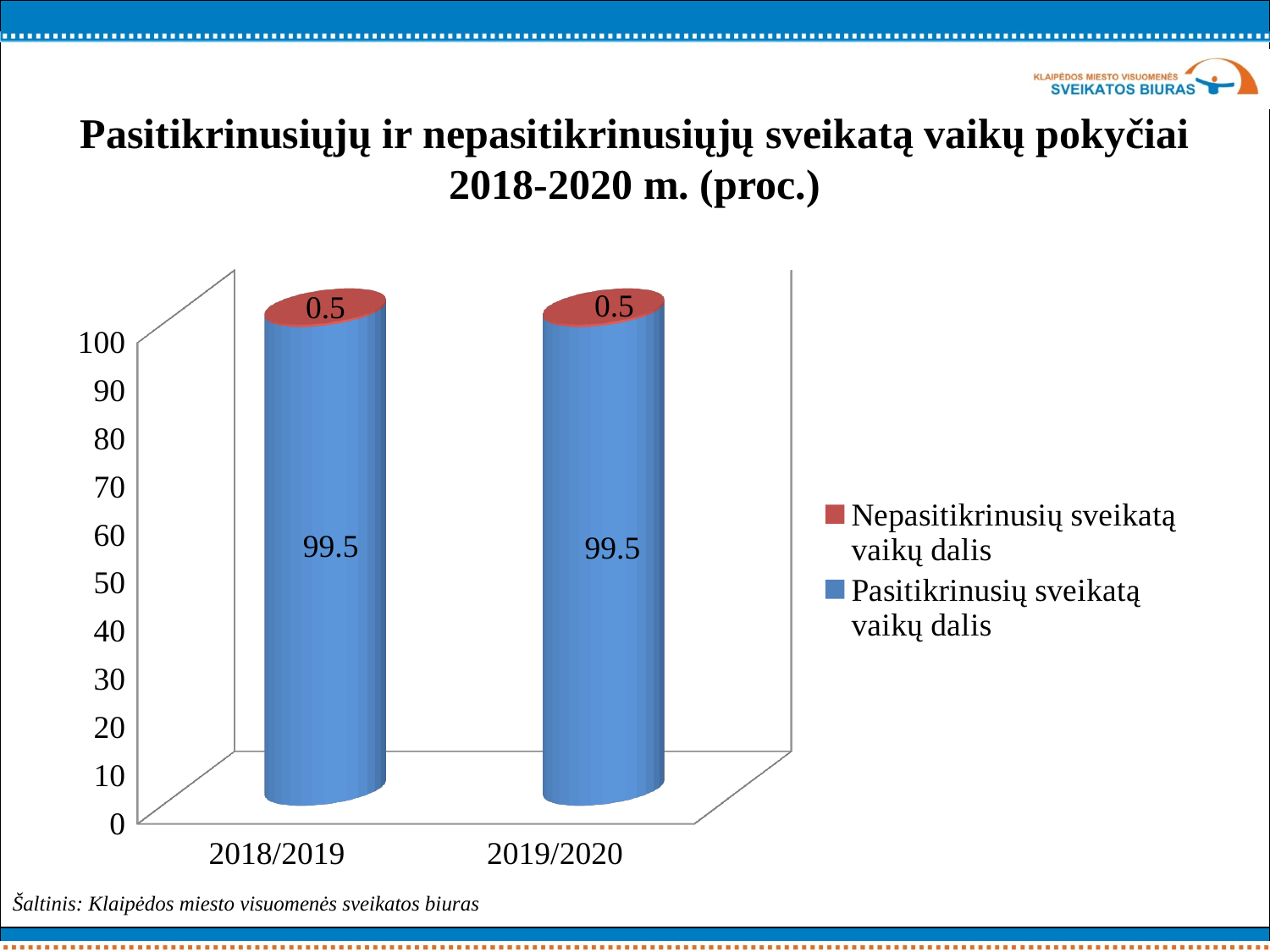
What is the value for 'Nepasitikrinusių sveikatą vaikų dalis' in 2018/2019? 0.5 What is the difference between the 'Pasitikrinusių sveikatą vaikų dalis' and 'Nepasitikrinusių sveikatą vaikų dalis' values in 2019/2020? 99 Which colour represents 'Nepasitikrinusių sveikatą vaikų dalis' in the chart? Red What kind of chart is shown on the slide? Stacked bar chart How many categories are shown on the x axis? 2 How many series does the legend list? 2 What is the total of the stacked bar for 2018/2019? 100 Which series has the larger value in 2018/2019, 'Pasitikrinusių sveikatą vaikų dalis' or 'Nepasitikrinusių sveikatą vaikų dalis'? Pasitikrinusių sveikatą vaikų dalis Does the value for 'Pasitikrinusių sveikatą vaikų dalis' rise, fall or stay the same from 2018/2019 to 2019/2020? Stays the same What is the value for 'Nepasitikrinusių sveikatą vaikų dalis' in 2019/2020? 0.5 What is the value for 'Pasitikrinusių sveikatą vaikų dalis' in 2019/2020? 99.5 What is the value for 'Pasitikrinusių sveikatą vaikų dalis' in 2018/2019? 99.5